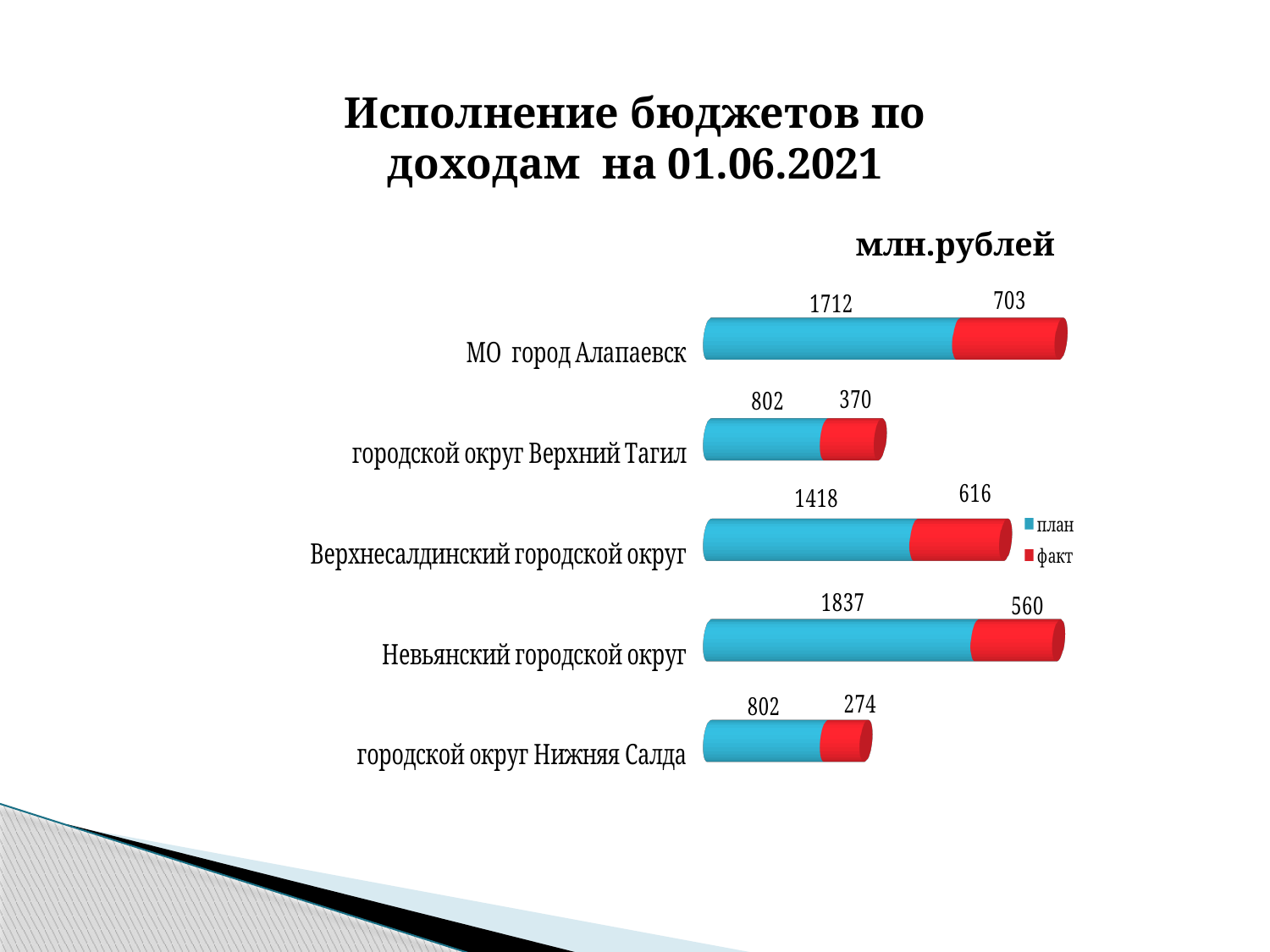
What is the difference between the план and факт values for городской округ Верхний Тагил? 432 What is the план value for Верхнесалдинский городской округ? 1418 How many categories are shown in the chart? 5 What is the план value for Невьянский городской округ? 1837 What is the факт value for МО город Алапаевск? 703 What unit is stated above the chart? млн.рублей Which is larger: the факт value for Верхнесалдинский городской округ or the факт value for Невьянский городской округ? Верхнесалдинский городской округ Which category has the lowest факт value? городской округ Нижняя Салда What kind of chart is shown on the slide? bar chart Which category has the highest план value? Невьянский городской округ What is the факт value for городской округ Нижняя Салда? 274 How many series does the legend list? 2